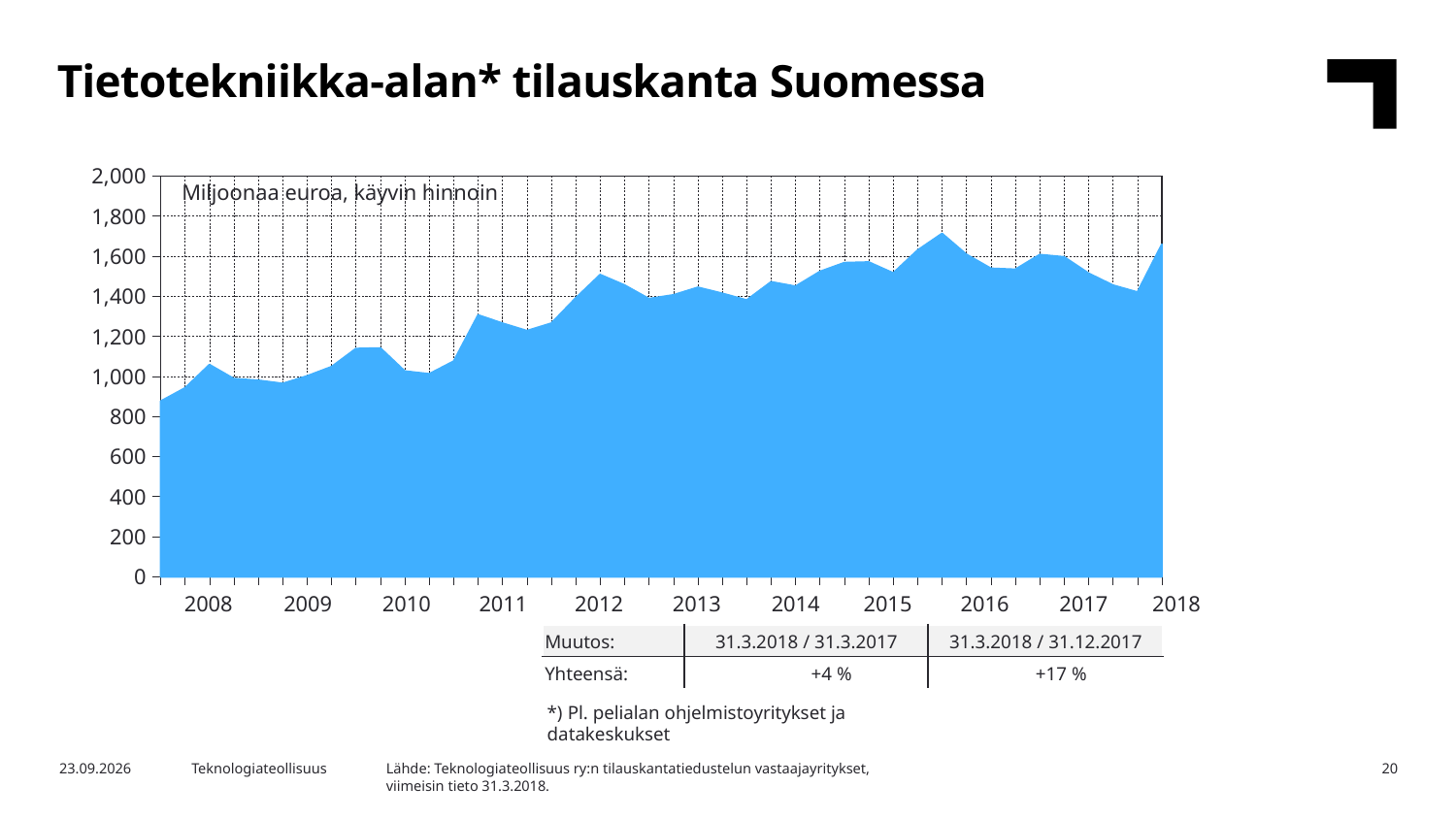
How many year labels are shown on the x axis? 11 According to the table below the chart, what is the change (Muutos) for 31.3.2018 / 31.12.2017? +17 % In which year does the series reach its lowest value? 2008 Is the value at the end of the series in 2018 greater or less than 1,400? greater What type of chart is shown on the slide? Area chart Is the value at the start of 2008 greater or less than 1,000? less What unit is stated inside the chart area? Miljoonaa euroa, käyvin hinnoin Is the value during 2009 greater or less than 1,200? less Which is larger, the value at the start of 2008 or the value at the end of 2018? 2018 What is the title of the chart on the slide? Tietotekniikka-alan* tilauskanta Suomessa Overall, does the order backlog rise or fall from 2008 to 2018? rise